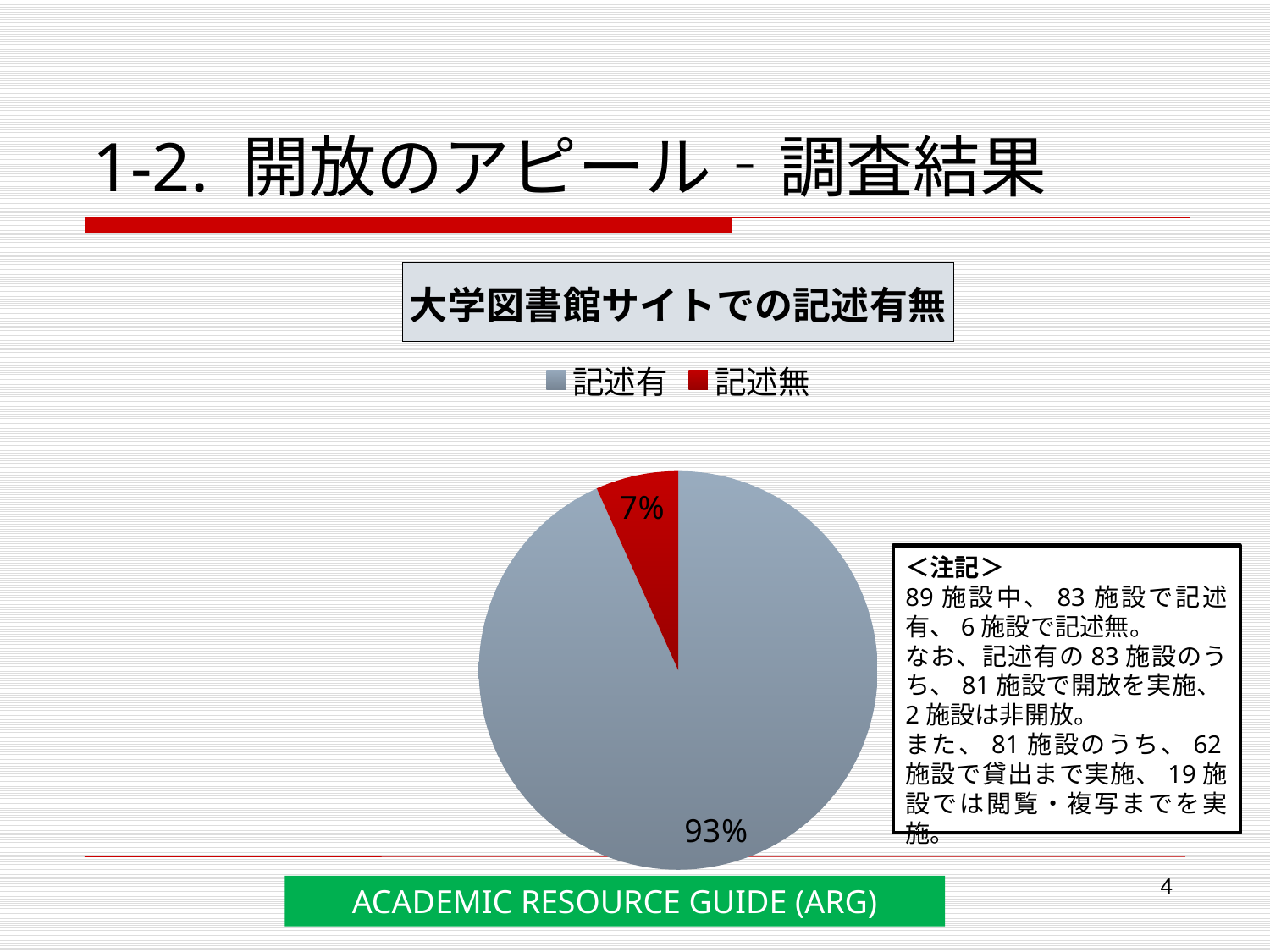
What share of the pie does 記述無 take? 7% Which category has the largest slice of the pie? 記述有 How many categories does the legend list? 2 What kind of chart is shown on the slide? pie chart What colour is the 記述無 slice? red Which category has the smallest slice of the pie? 記述無 What is the title of the chart? 大学図書館サイトでの記述有無 What share of the pie does 記述有 take? 93% What is the difference in percentage points between the 記述有 and 記述無 slices? 86 How many slices does the pie chart have? 2 Which is larger, the share for 記述有 or the share for 記述無? 記述有